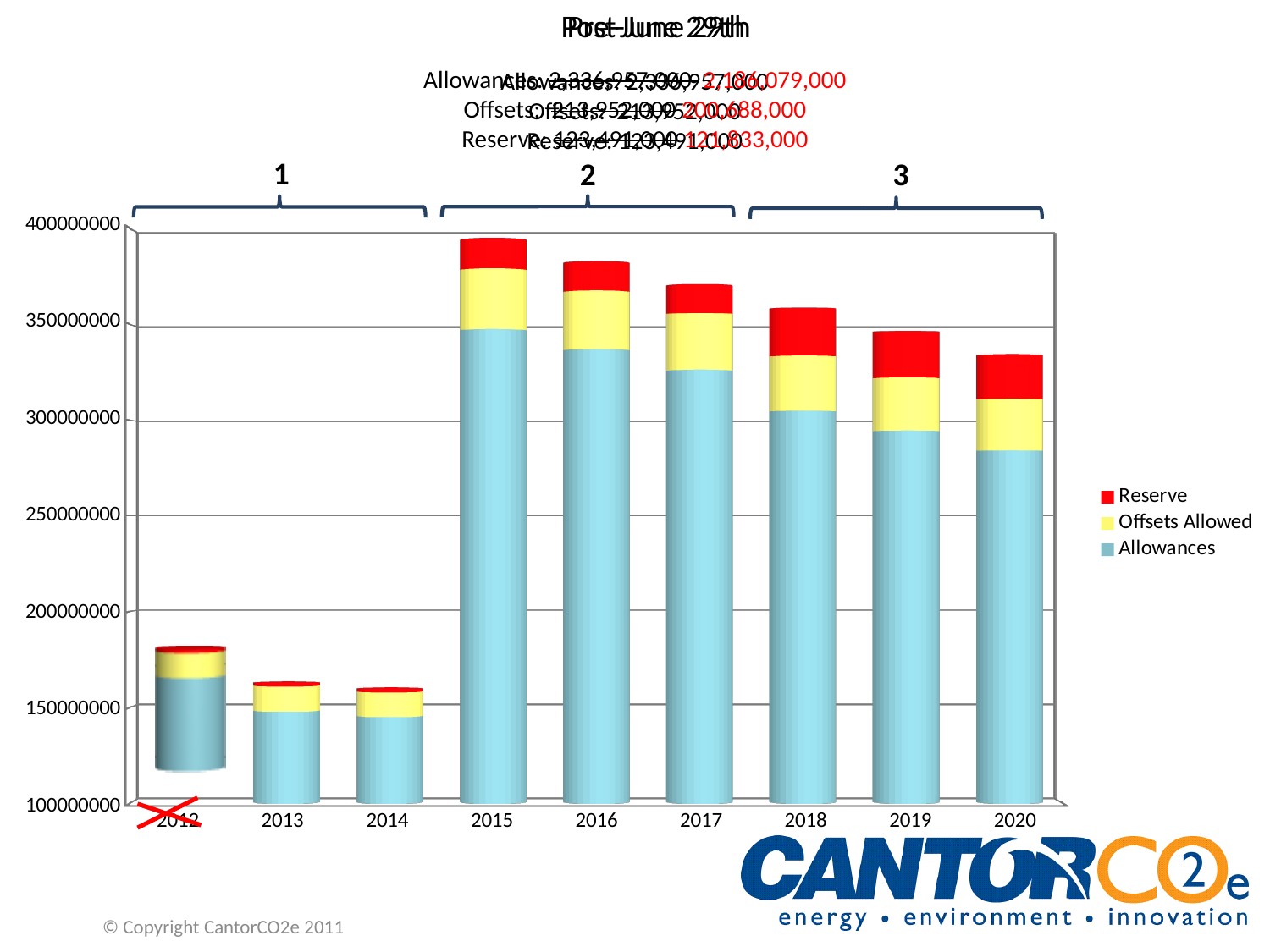
Is the total for 2015 greater or less than 350000000? greater How many years are shown along the x axis? 9 Which series is shown in red in the legend? Reserve Which year has the highest total stacked bar? 2015 Is the Allowances value for 2019 greater or less than 300000000? less Which has the larger total, 2013 or 2018? 2018 Is the total for 2020 greater or less than 350000000? less What kind of chart is shown on the slide? stacked bar chart How many series does the legend list? 3 Do the total bar heights rise or fall from 2015 to 2020? fall